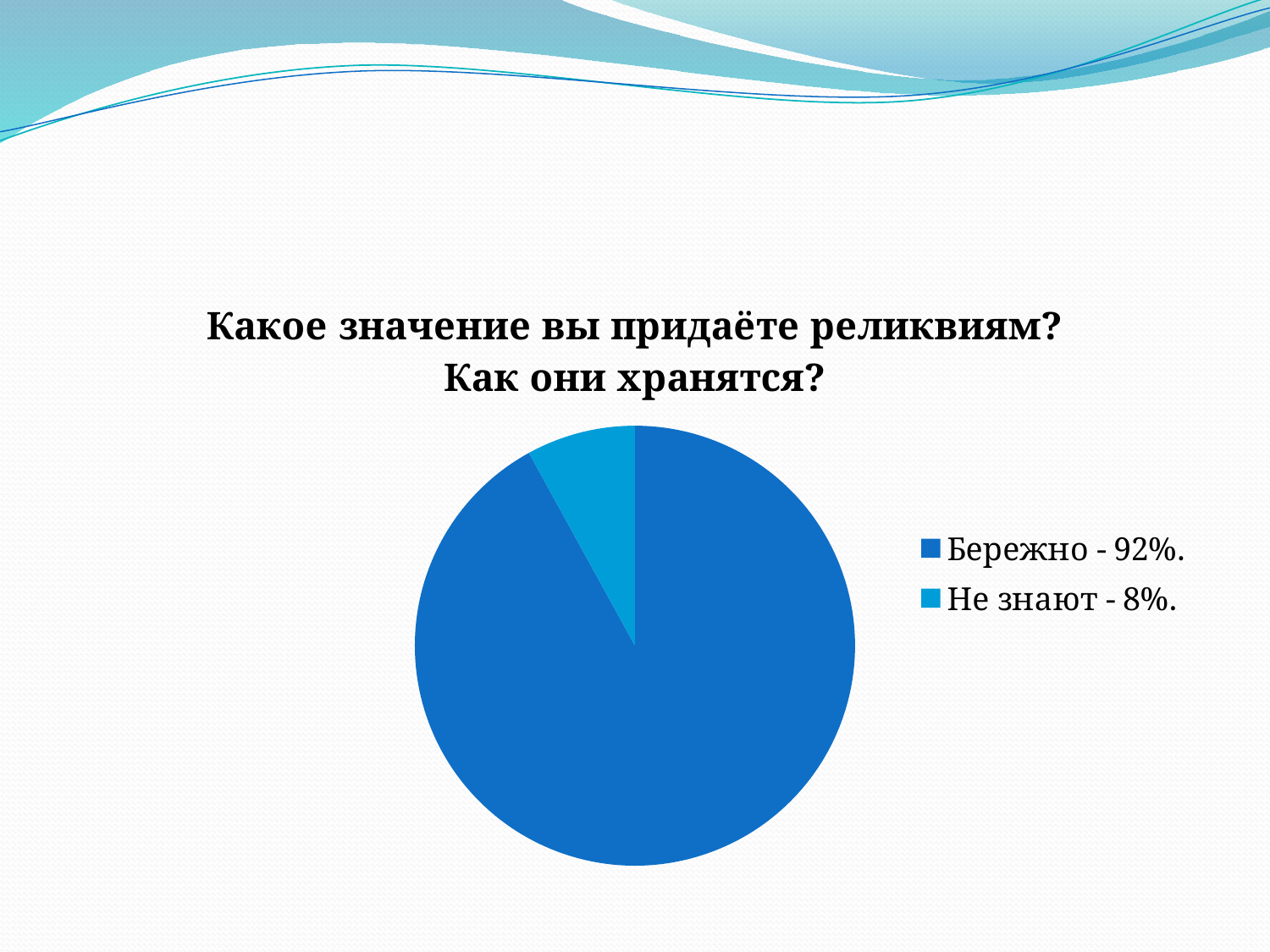
What is the title of the chart? Какое значение вы придаёте реликвиям? Как они хранятся? What kind of chart is shown on the slide? pie chart What share of the pie is labelled "Не знают"? 8% Which is larger, the "Бережно" slice or the "Не знают" slice? Бережно How many entries does the legend list? 2 What is the difference in percentage points between "Бережно" and "Не знают"? 84 Which legend entry is shown in the lighter blue colour? Не знают - 8%. Which slice is the smallest? Не знают What share of the pie is labelled "Бережно"? 92% What is the total of the two percentages shown in the legend? 100% Which slice is the largest? Бережно How many slices does the pie chart have? 2